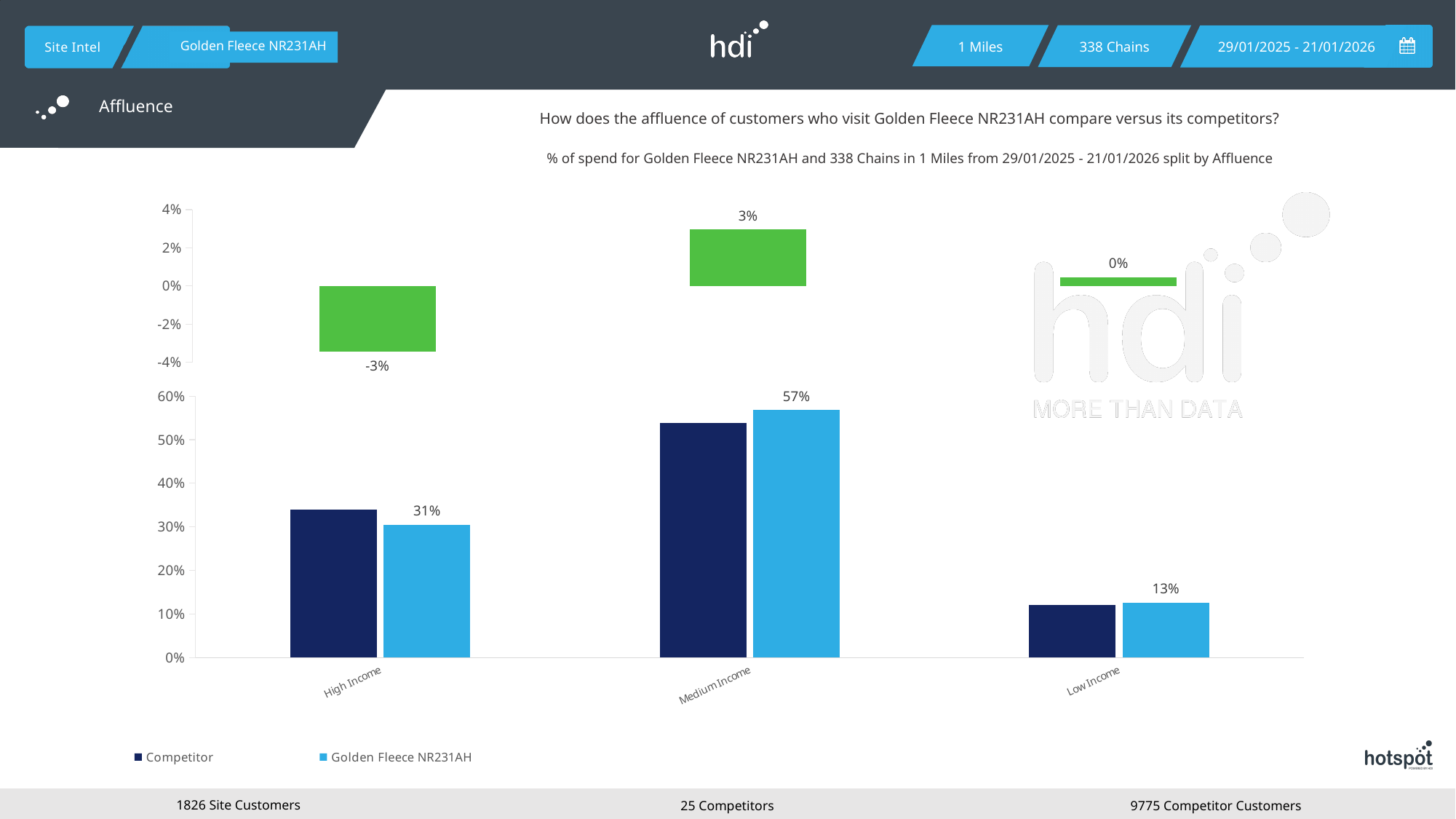
In the bottom chart, which category has the highest value for Golden Fleece NR231AH? Medium Income In the bottom chart, which category has the lowest value for Golden Fleece NR231AH? Low Income In the bottom chart, what is the value for Golden Fleece NR231AH in the High Income category? 31% In the bottom chart, what is the value for Golden Fleece NR231AH in the Low Income category? 13% In the bottom chart, is the Competitor value for High Income greater or less than 30%? greater In the top chart, what is the value shown for the Medium Income category? 3% In the bottom chart, what is the value for Golden Fleece NR231AH in the Medium Income category? 57% What kind of chart is the bottom chart? Bar chart In the bottom chart, how many series does the legend list? 2 In the bottom chart, what is the difference between the Golden Fleece NR231AH values for Medium Income and High Income? 26% In the top chart, what is the value shown for the High Income category? -3% In the bottom chart, is the Competitor value for Medium Income greater or less than 50%? greater